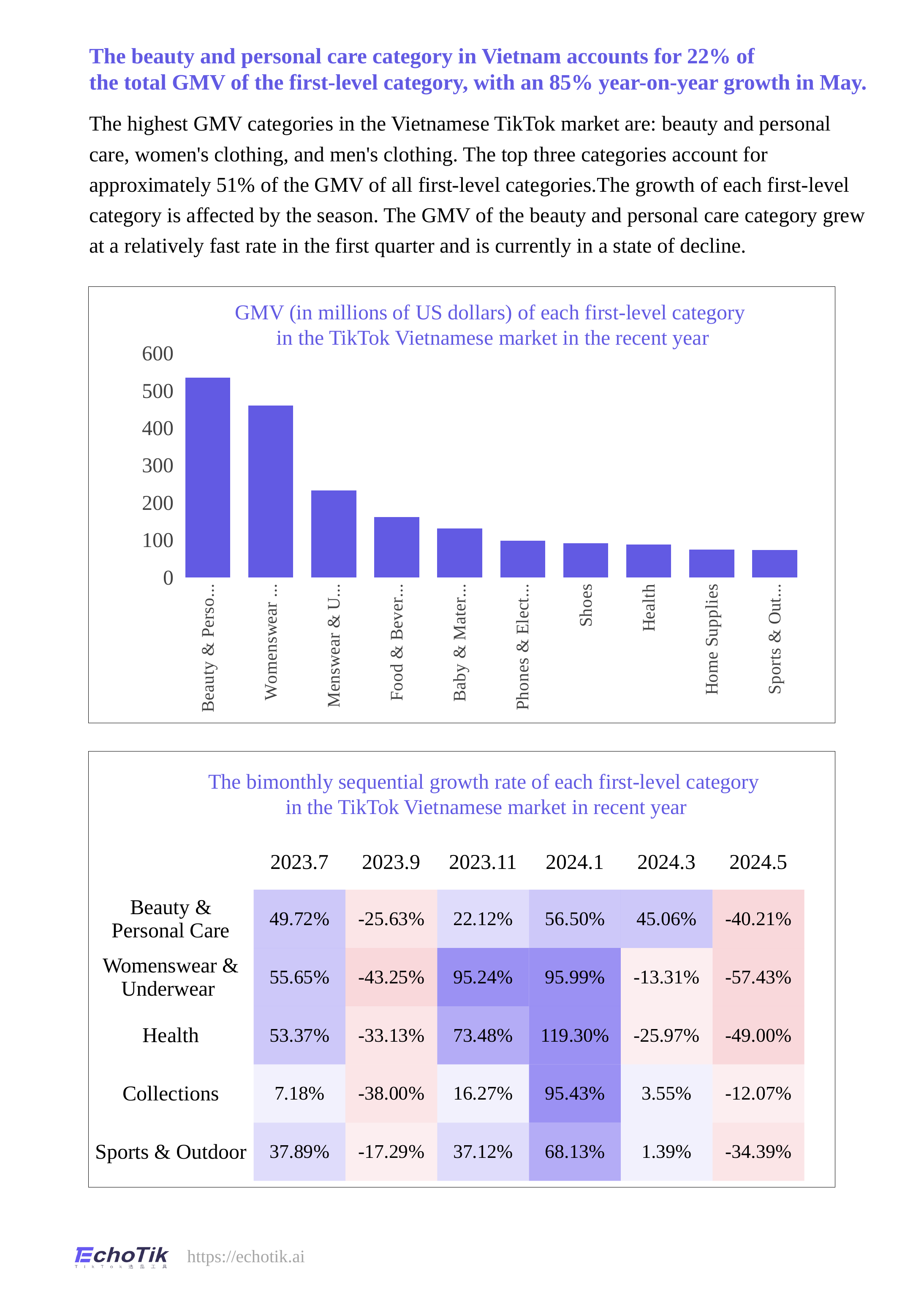
In the GMV bar chart, do the values rise or fall from left to right along the x axis? fall In the GMV bar chart, which category has the highest GMV? Beauty & Personal Care In the GMV bar chart, is the value for Shoes greater or less than 100? less In the bimonthly growth rate table, how many first-level categories are listed? 5 In the bimonthly growth rate table, which category has the highest growth rate in 2024.1? Health In the GMV bar chart, how many first-level categories are shown? 10 In the GMV bar chart, which is larger, the GMV of Menswear or of Food & Beverage? Menswear In the bimonthly growth rate table, what is the growth rate for Health in 2024.1? 119.30% In the GMV bar chart, is the value for Womenswear greater or less than 500? less What kind of chart is the GMV chart at the top of the slide? bar chart In the GMV bar chart, is the value for Beauty & Personal Care greater or less than 500? greater In the bimonthly growth rate table, what is the growth rate for Womenswear & Underwear in 2024.5? -57.43%